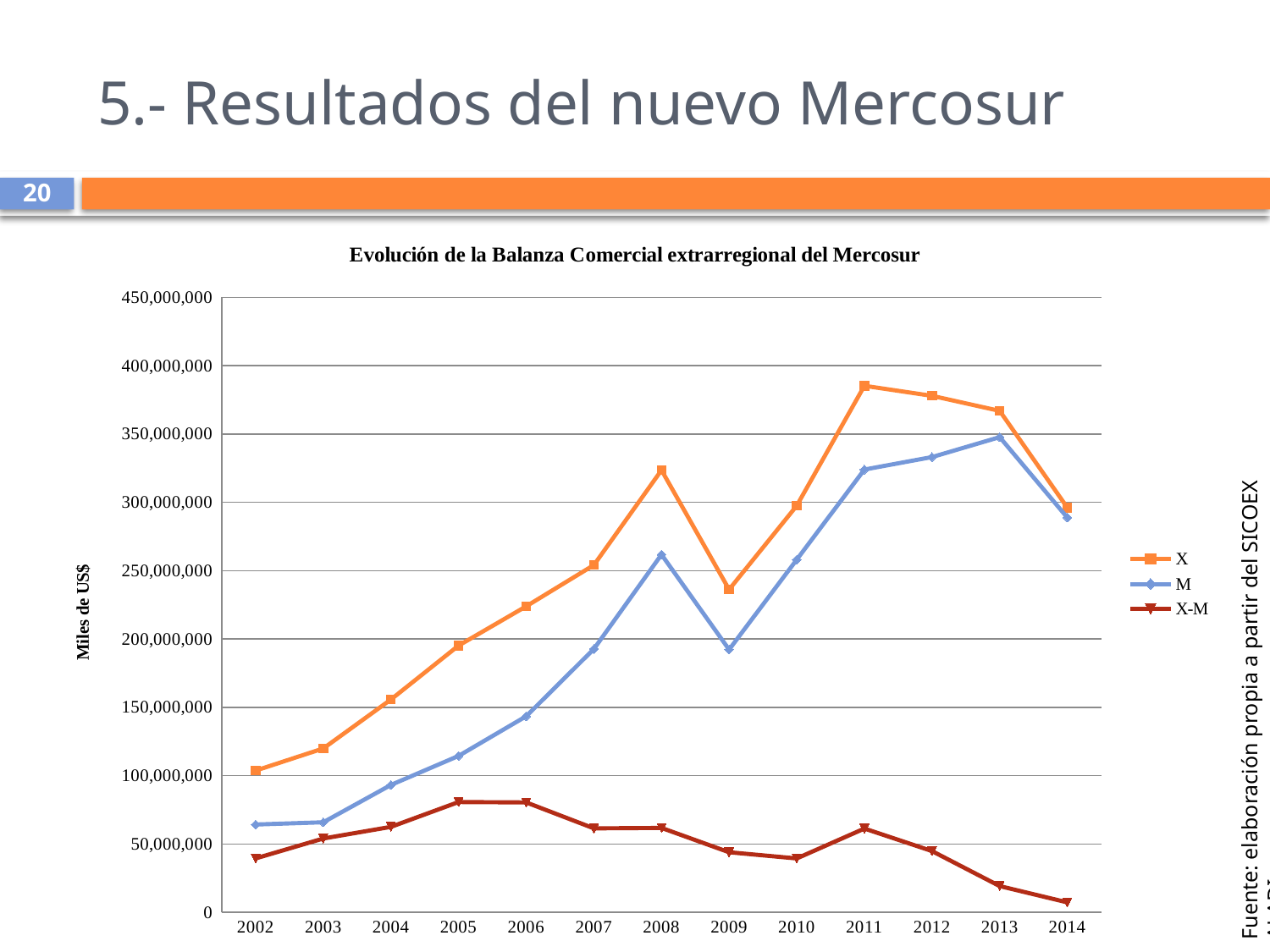
How many series does the legend list? 3 In which year does the M series reach its highest value? 2013 Is the value for X-M in 2014 greater or less than 50,000,000? less What kind of chart is shown on the slide? line chart In which year is the X-M series at its lowest value? 2014 Is the value for X in 2011 greater or less than 350,000,000? greater Which series has the larger value in 2008, X or M? X In which year is the X series at its lowest value? 2002 How many years are plotted along the x axis? 13 Does the X-M series rise or fall from 2011 to 2014? fall Is the value for X in 2008 greater or less than 300,000,000? greater In which year does the X series reach its highest value? 2011